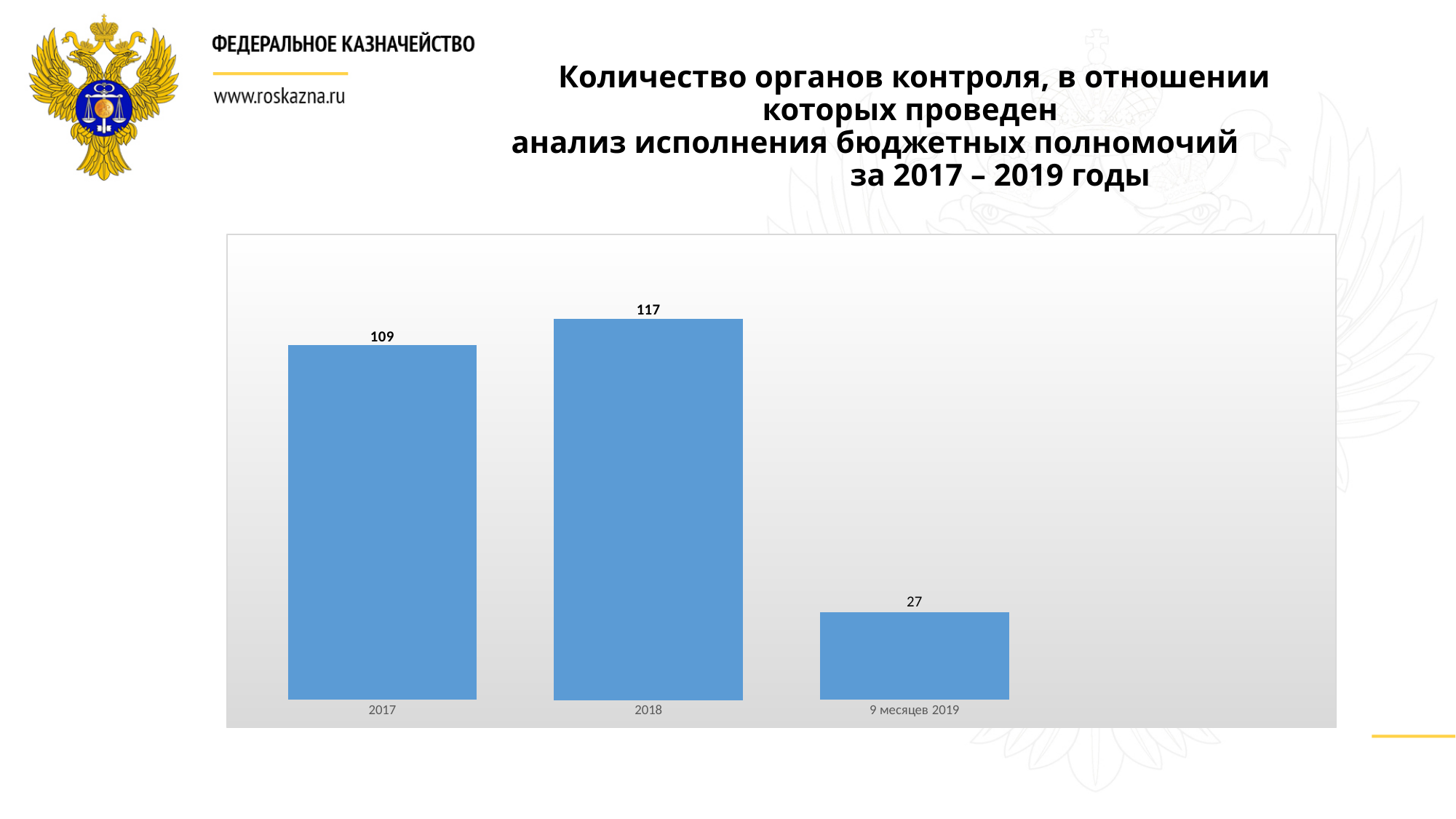
How many categories are shown on the x axis? 3 What is the value for 2018? 117 Which is larger, the value for 2017 or the value for 2018? 2018 What is the difference between the values for 2018 and 2017? 8 What is the difference between the values for 2017 and 9 месяцев 2019? 82 What is the value for 2017? 109 Does the value rise or fall from 2018 to 9 месяцев 2019? fall What kind of chart is shown on the slide? bar chart What colour are the bars in the chart? blue Which category has the highest value? 2018 What is the value for 9 месяцев 2019? 27 Which category has the lowest value? 9 месяцев 2019